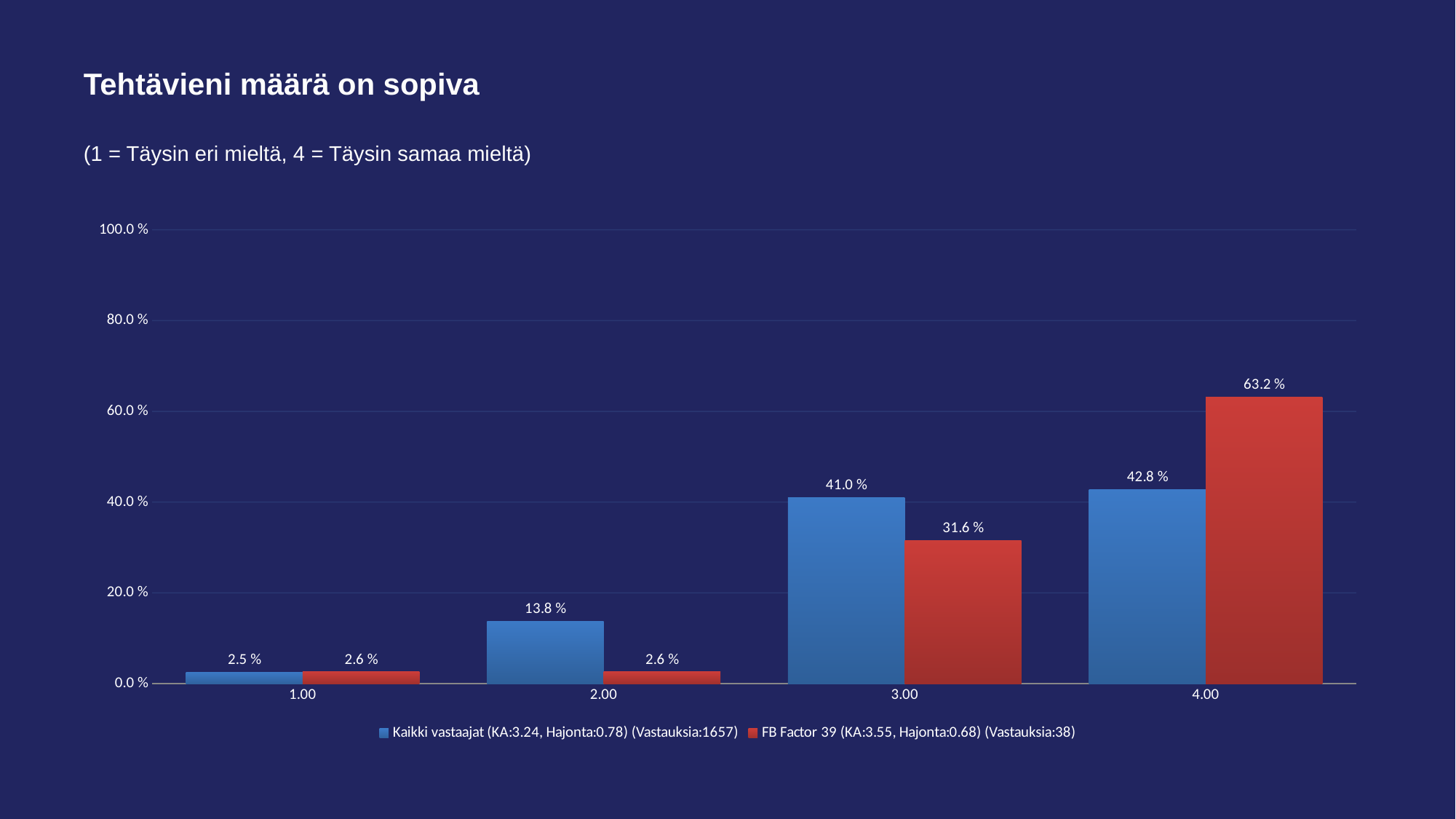
What is the value for the 'Kaikki vastaajat' series at category 3.00? 41.0 % What is the difference between the 'FB Factor 39' and 'Kaikki vastaajat' values at category 4.00? 20.4 % What is the title of the chart? Tehtävieni määrä on sopiva What is the value for the 'Kaikki vastaajat' series at category 2.00? 13.8 % What kind of chart is shown on the slide? Bar chart What is the value for the 'FB Factor 39' series at category 1.00? 2.6 % Which category has the highest value for the 'FB Factor 39' series? 4.00 Which category has the lowest value for the 'Kaikki vastaajat' series? 1.00 How many categories are shown on the x axis? 4 At category 3.00, which series has the larger value, 'Kaikki vastaajat' or 'FB Factor 39'? Kaikki vastaajat What is the value for the 'FB Factor 39' series at category 4.00? 63.2 % How many series does the legend list? 2